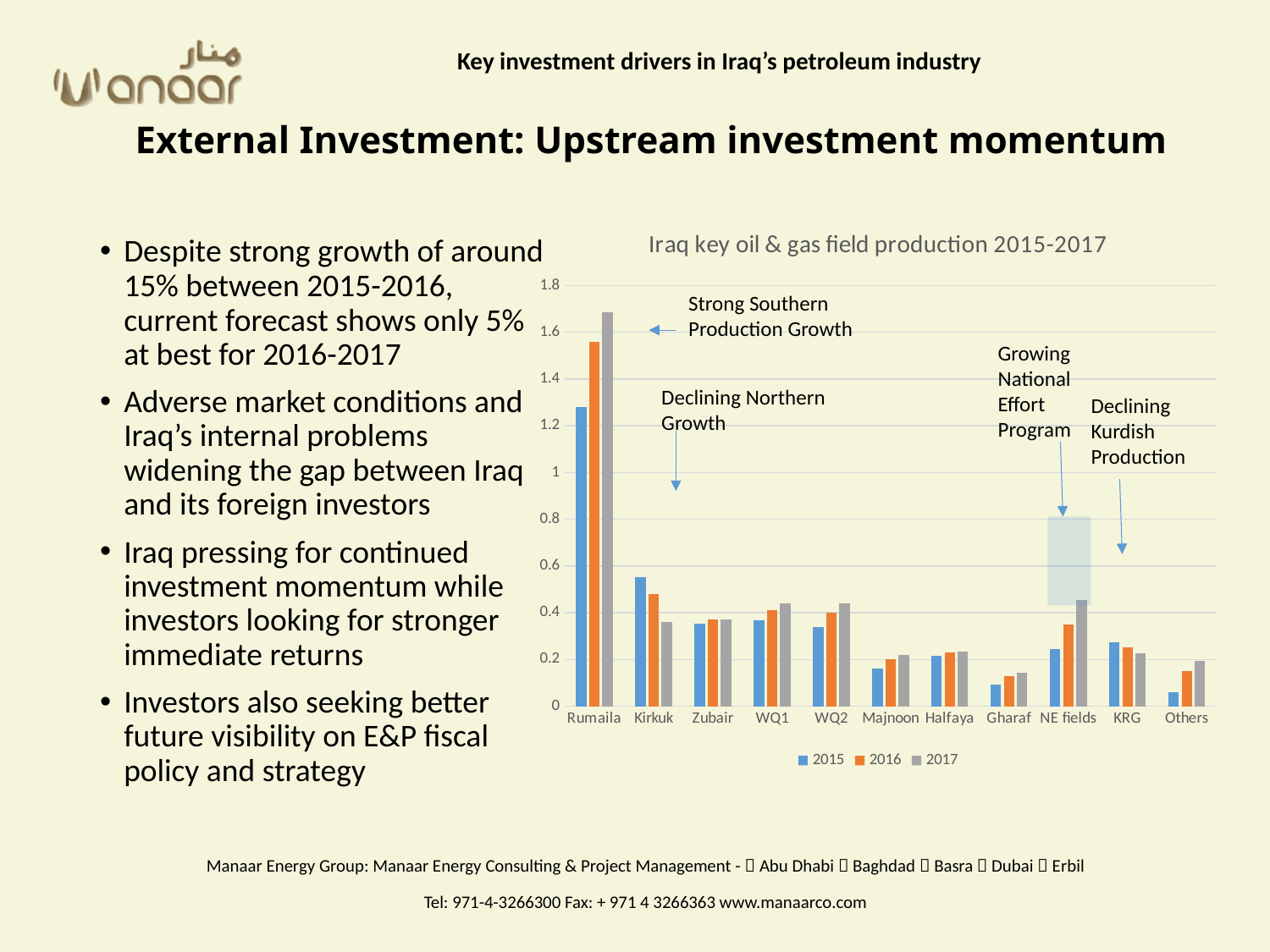
Do the values for Rumaila rise or fall from 2015 to 2017? rise How many field categories are shown on the x axis of the chart? 11 Is the 2015 value for Kirkuk greater or less than 0.4? greater Is the 2015 value for Rumaila greater or less than 1.2? greater Which field has the highest 2017 production in the chart? Rumaila Which is larger for Kirkuk: the 2015 value or the 2017 value? 2015 Is the 2015 value for Majnoon greater or less than 0.2? less Which category has the lowest 2015 value in the chart? Others What is the title of the chart? Iraq key oil & gas field production 2015-2017 What type of chart is shown on the slide? Bar chart How many series does the chart legend list? 3